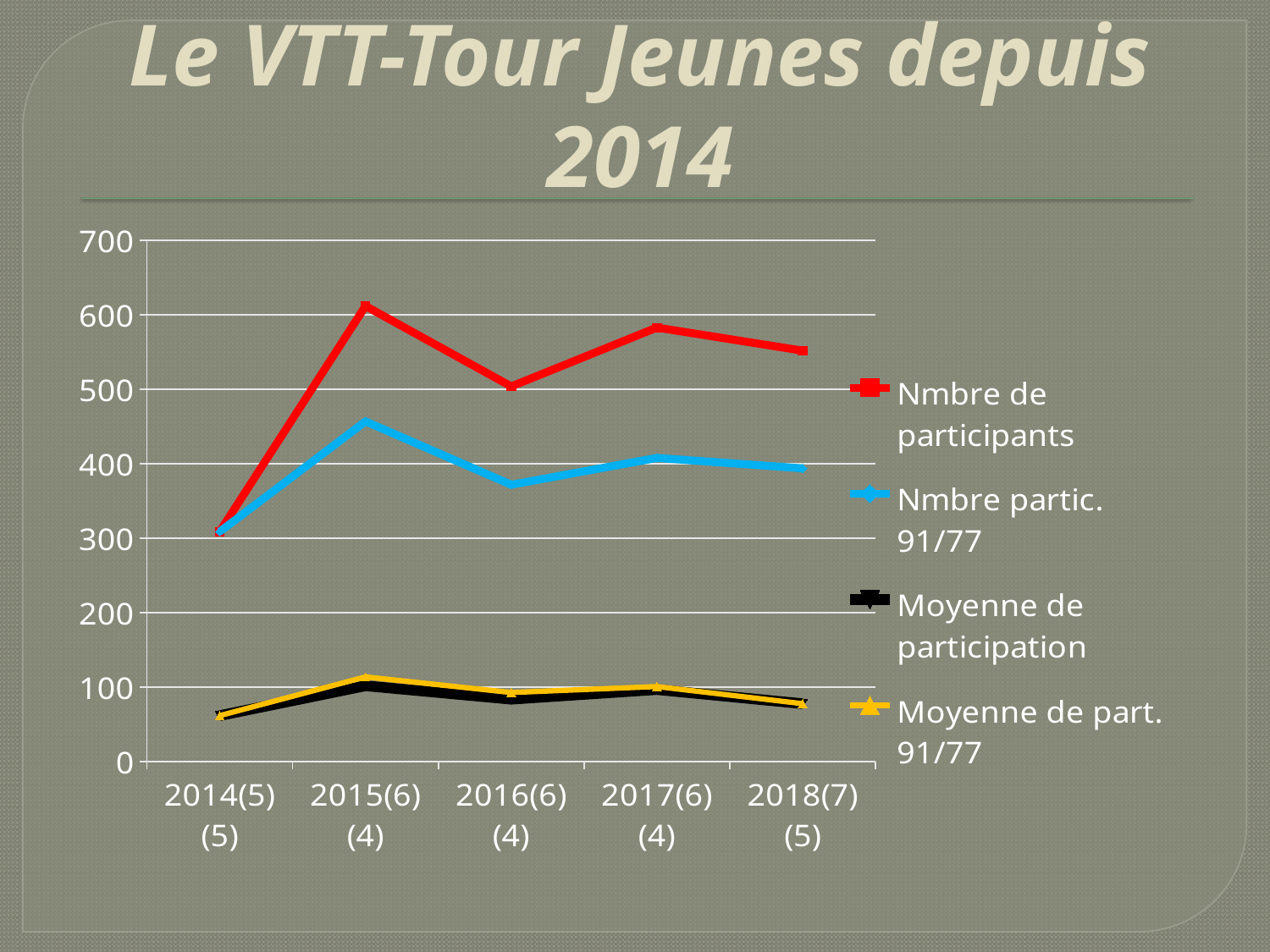
Is the value of 'Nmbre partic. 91/77' for 2016(6) (4) greater or less than 400? less How many categories are shown on the x axis? 5 In which category does the 'Nmbre partic. 91/77' series reach its highest value? 2015(6) (4) Does the 'Nmbre de participants' series rise or fall from 2014(5) (5) to 2015(6) (4)? rise What colour is the line for 'Moyenne de part. 91/77'? yellow Which is larger for 'Nmbre de participants': the value for 2015(6) (4) or the value for 2016(6) (4)? 2015(6) (4) Is the value of 'Nmbre de participants' for 2015(6) (4) greater or less than 500? greater What kind of chart is shown on the slide? line chart How many series does the legend list? 4 In which category does the 'Nmbre de participants' series reach its highest value? 2015(6) (4) In which category is the 'Nmbre de participants' series at its lowest? 2014(5) (5) Is the value of 'Nmbre de participants' for 2014(5) (5) greater or less than 400? less